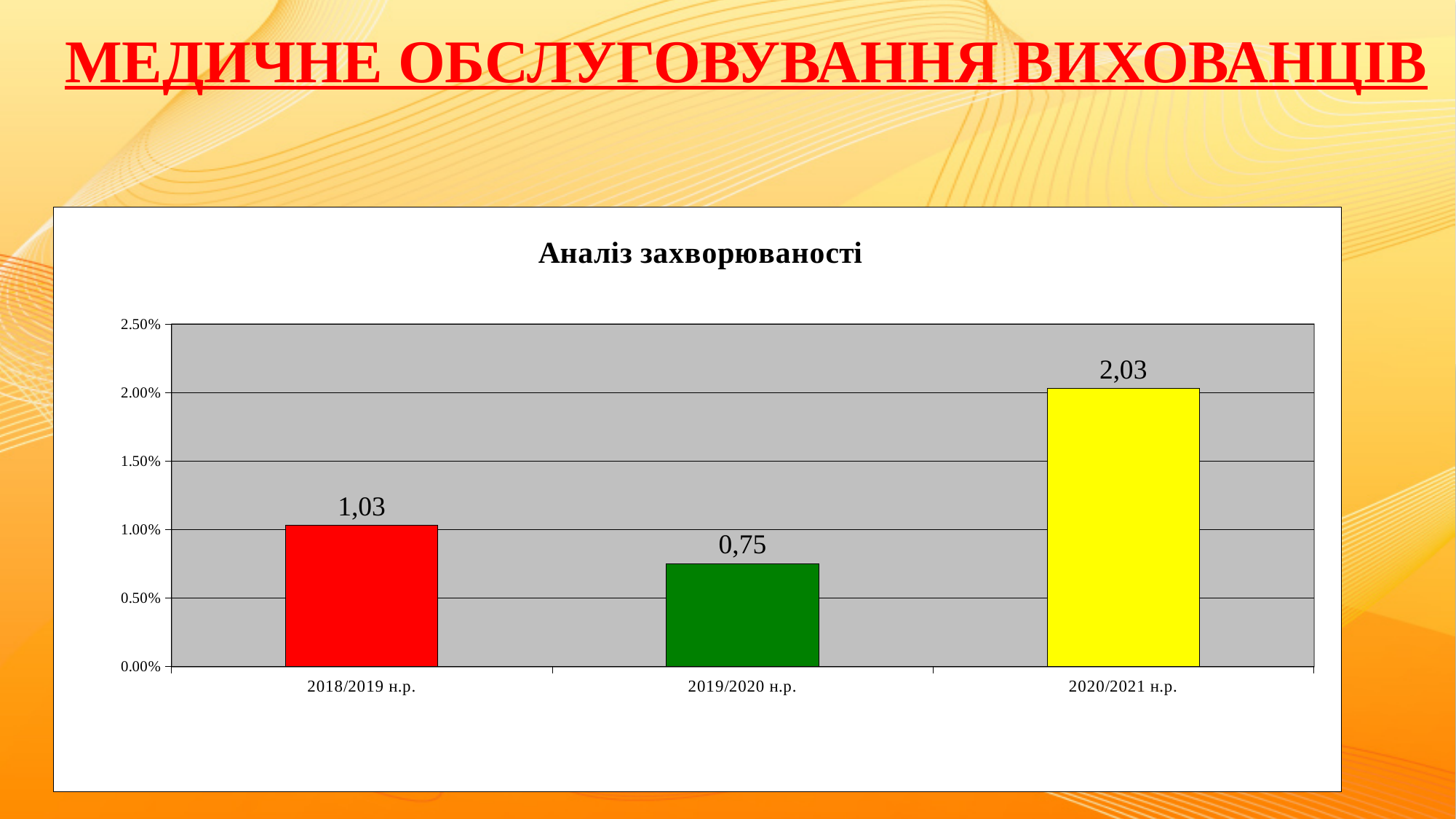
What is the value shown for 2020/2021 н.р.? 2,03 How many academic years are shown on the chart? 3 What is the value shown for 2019/2020 н.р.? 0,75 What is the difference between the values for 2020/2021 н.р. and 2018/2019 н.р.? 1,00 What kind of chart is shown on the slide? bar chart What is the value shown for 2018/2019 н.р.? 1,03 Is the value for 2020/2021 н.р. greater or less than 1.50%? greater What is the difference between the values for 2018/2019 н.р. and 2019/2020 н.р.? 0,28 What is the title of the chart? Аналіз захворюваності Which is larger, the value for 2018/2019 н.р. or for 2019/2020 н.р.? 2018/2019 н.р. Which academic year has the highest value? 2020/2021 н.р. Which academic year has the lowest value? 2019/2020 н.р.